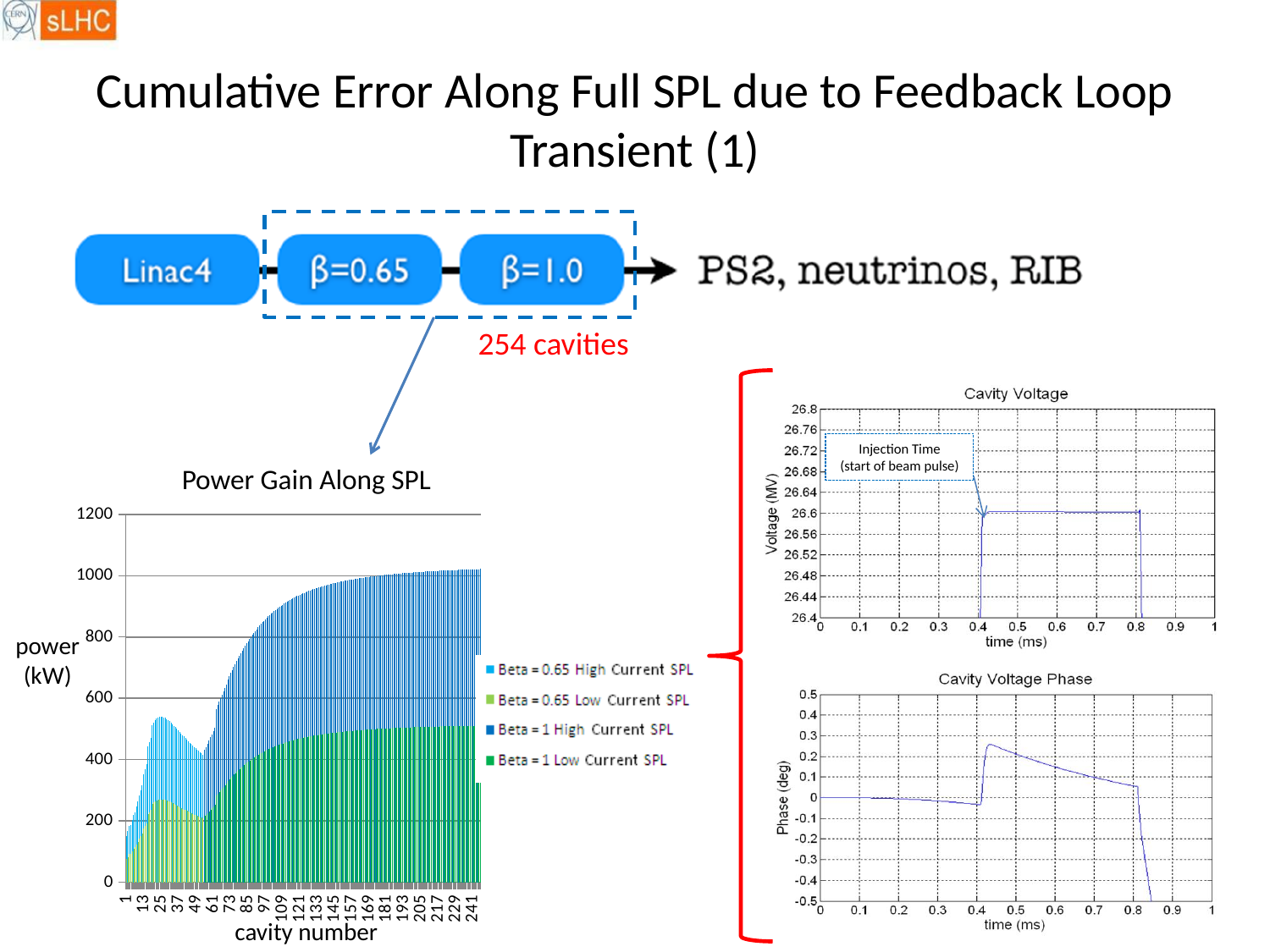
In the "Power Gain Along SPL" chart, is the highest value for Beta = 0.65 Low Current SPL greater or less than 400? less What kind of chart is the "Cavity Voltage" chart? line chart In the "Cavity Voltage Phase" chart, does the phase rise or fall between 0.45 ms and 0.8 ms? fall What kind of chart is the "Power Gain Along SPL" chart? bar chart In the "Power Gain Along SPL" chart, what is the label of the vertical axis? power (kW) How many series does the legend of the "Power Gain Along SPL" chart list? 4 In the "Power Gain Along SPL" chart, which series reaches the highest power values? Beta = 1 High Current SPL In the "Power Gain Along SPL" chart, what is the highest value shown on the vertical axis? 1200 In the "Power Gain Along SPL" chart, is the value for Beta = 1 High Current SPL at cavity number 241 greater or less than 800? greater In the "Cavity Voltage" chart, is the voltage at 0.6 ms greater or less than 26.5 MV? greater In the "Power Gain Along SPL" chart, does the Beta = 1 High Current SPL power rise or fall as the cavity number increases from 61 to 241? rise